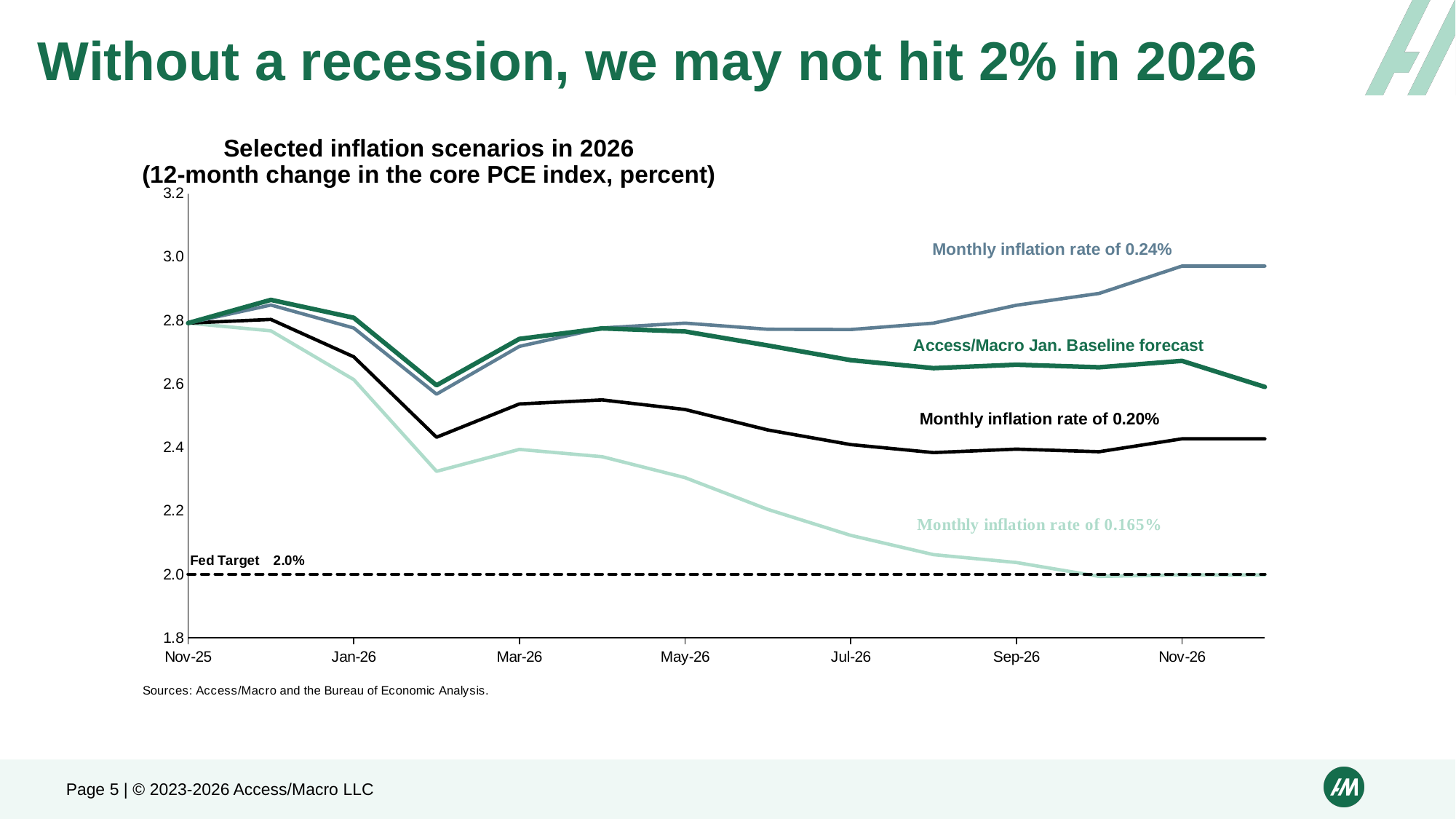
Which scenario line is lowest at Nov-26? Monthly inflation rate of 0.165% Does the Monthly inflation rate of 0.165% line generally rise or fall from Mar-26 to Nov-26? fall Does the Monthly inflation rate of 0.24% line generally rise or fall from Jul-26 to Nov-26? rise At Sep-26, which is higher: the Access/Macro Jan. Baseline forecast or the Monthly inflation rate of 0.20% line? Access/Macro Jan. Baseline forecast Is the value of the Monthly inflation rate of 0.165% line at Mar-26 greater or less than 2.2? greater What value is the dashed Fed Target line drawn at? 2.0% Is the value of the Monthly inflation rate of 0.24% line at Nov-26 greater or less than 2.8? greater Is the value of the Access/Macro Jan. Baseline forecast line at Jul-26 greater or less than 2.8? less What is the title of the chart? Selected inflation scenarios in 2026 (12-month change in the core PCE index, percent) What kind of chart is shown on the slide? line chart Which scenario line is highest at Nov-26? Monthly inflation rate of 0.24%